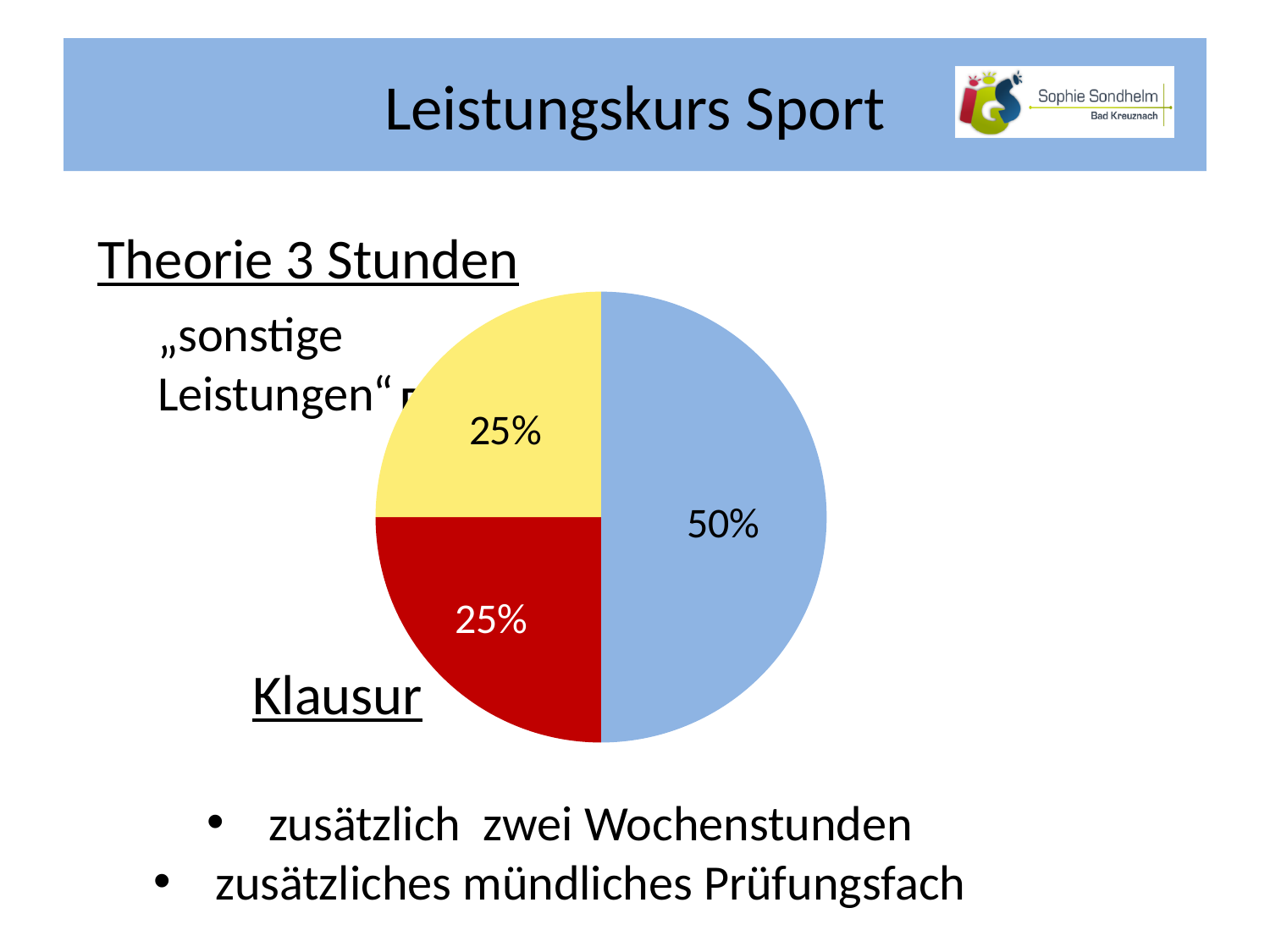
What percentage is shown on the yellow slice of the pie chart? 25% Which label is placed next to the yellow slice of the pie chart? „sonstige Leistungen“ How many slices does the pie chart have? 3 What percentage is shown on the red slice of the pie chart? 25% How many percentage points larger is the blue slice than the yellow slice? 25 Which colour slice is the largest in the pie chart? blue What share of the pie does the blue slice take? 50% Which is larger, the blue slice or the red slice? the blue slice What kind of chart is shown on the slide? pie chart What do the red and yellow slices add up to? 50% Which label is placed next to the red slice of the pie chart? Klausur What percentage is shown on the blue slice of the pie chart? 50%